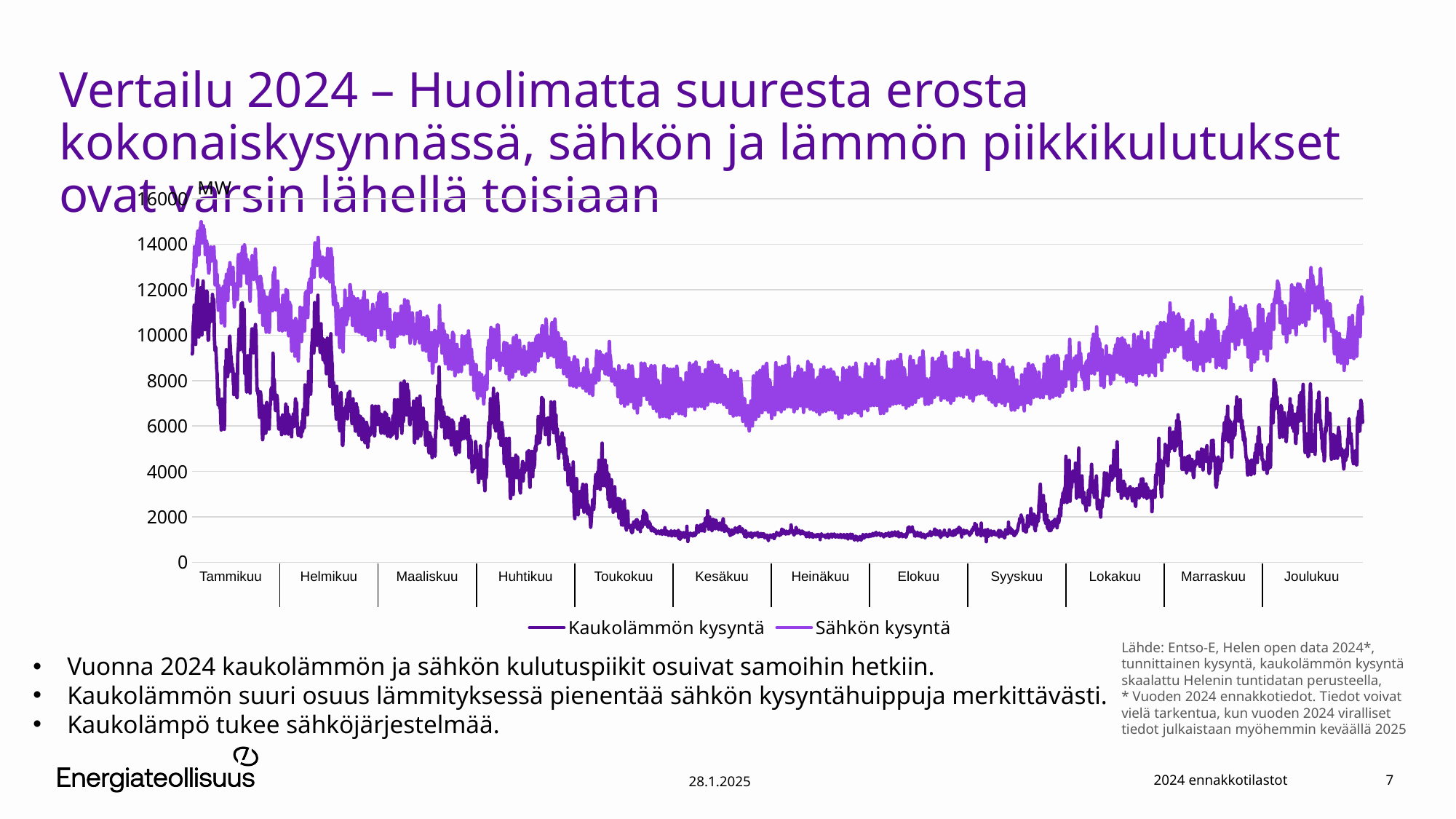
Is the value of Sähkön kysyntä during Tammikuu greater or less than 8000? greater What are the two series named in the chart legend? Kaukolämmön kysyntä and Sähkön kysyntä In which month does Sähkön kysyntä reach its highest peak? Tammikuu What kind of chart is shown on the slide? line chart Is the value of Kaukolämmön kysyntä during Tammikuu greater or less than 4000? greater Is the value of Sähkön kysyntä during Heinäkuu greater or less than 6000? greater Which series is higher during Heinäkuu, Kaukolämmön kysyntä or Sähkön kysyntä? Sähkön kysyntä How many months are labelled along the x axis of the chart? 12 How many series does the chart legend list? 2 Does Kaukolämmön kysyntä rise or fall from Tammikuu to Heinäkuu? fall What unit is shown on the y axis of the chart? MW